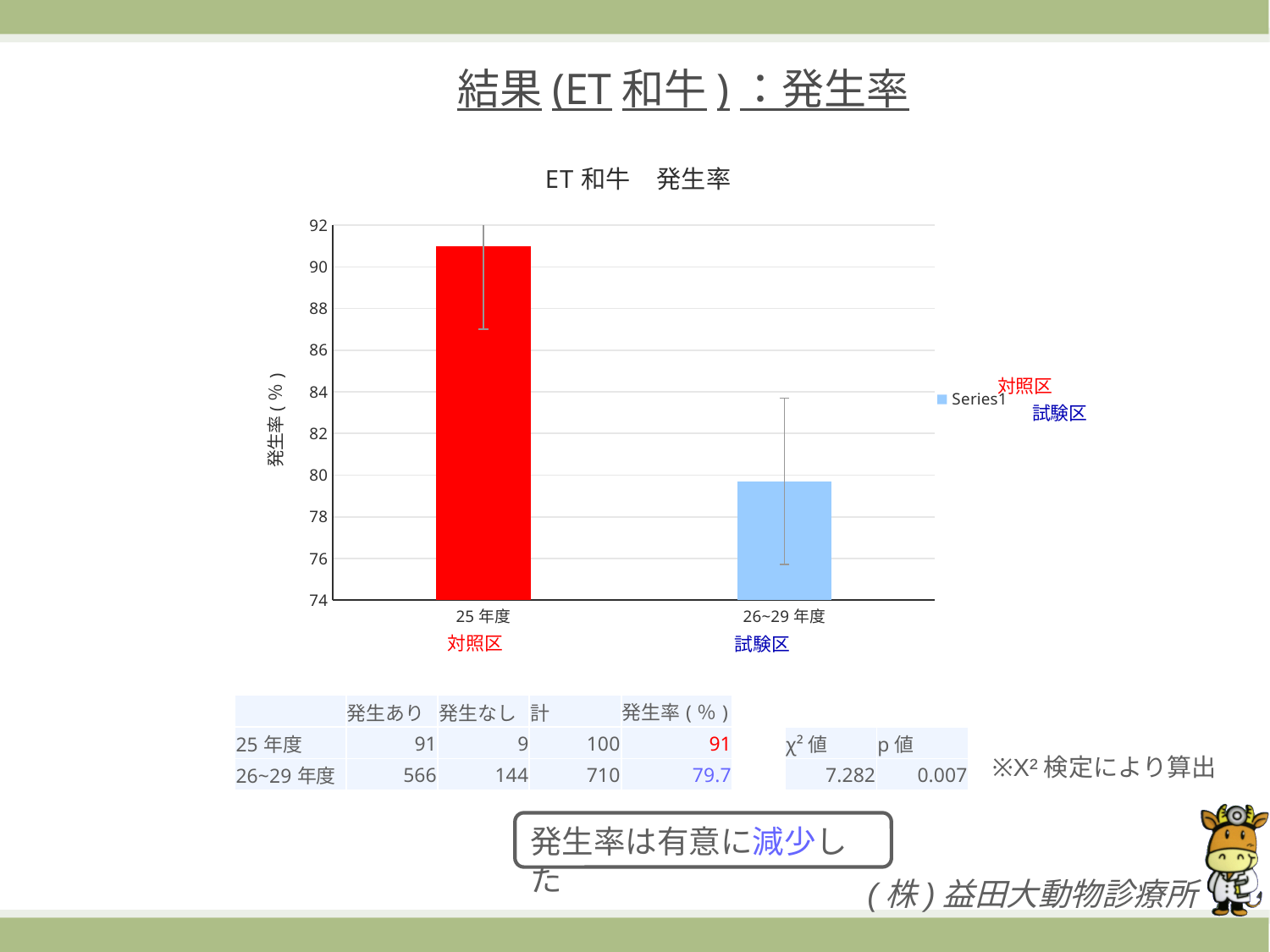
Is the value for 25 年度 greater or less than 90? greater What is the title of the chart? ET 和牛 発生率 Is the value for 26~29 年度 greater or less than 80? less Which category has the higher 発生率 in the chart, 25 年度 or 26~29 年度? 25 年度 According to the table below the chart, what is the 発生率 (%) for 26~29 年度? 79.7 What kind of chart is shown on the slide? bar chart What colour is the bar for 25 年度 (対照区)? red Do the values rise or fall from 25 年度 to 26~29 年度 along the x axis? fall How many bars (categories) does the chart show? 2 How many series does the chart legend list? 1 According to the table below the chart, what is the 発生率 (%) for 25 年度? 91 Which category has the lowest bar in the chart? 26~29 年度